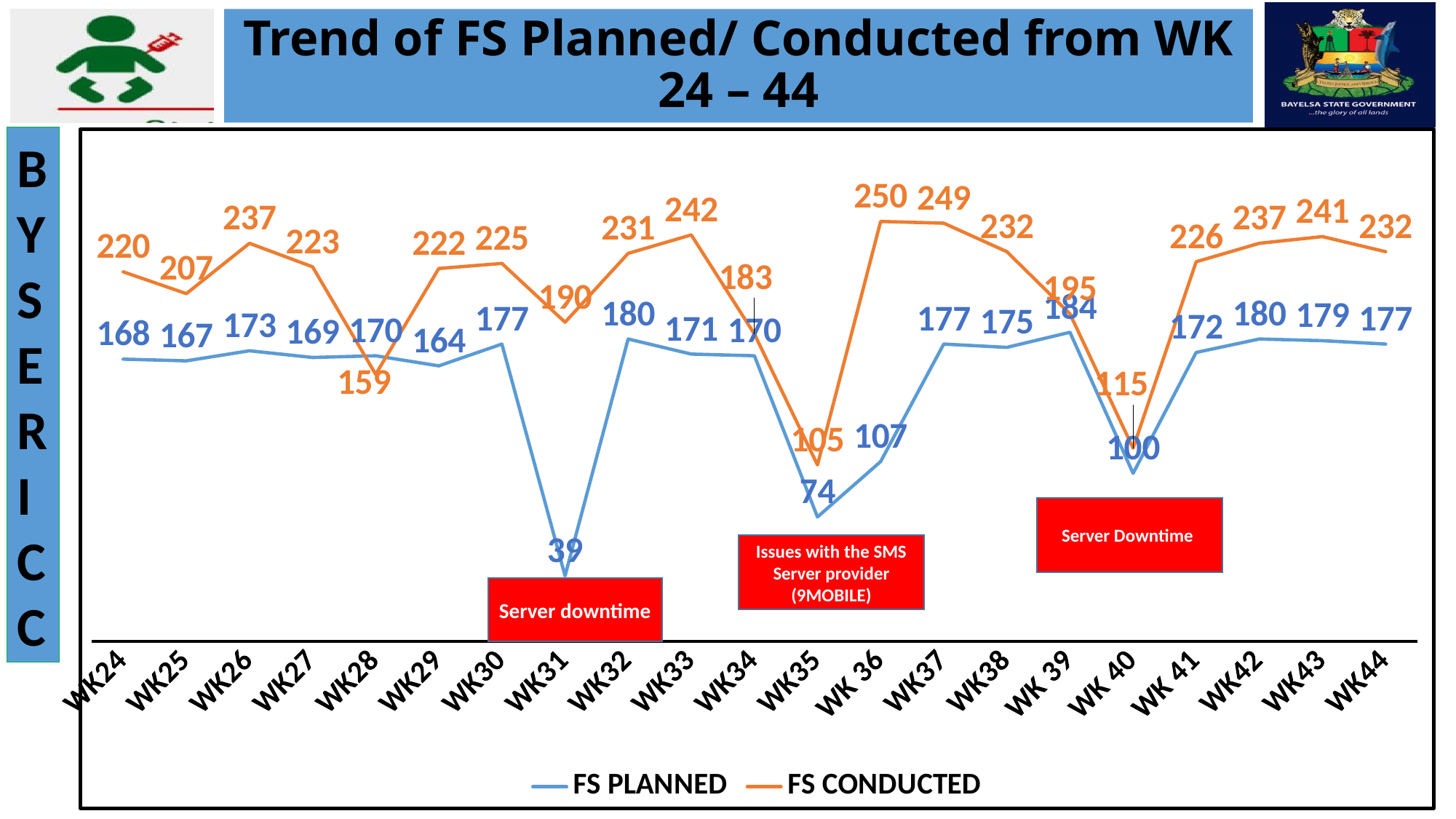
How many weeks are shown on the x axis? 21 In WK28, which series has the larger value, FS PLANNED or FS CONDUCTED? FS PLANNED What is the difference between FS CONDUCTED and FS PLANNED in WK 36? 143 What is the difference between FS CONDUCTED and FS PLANNED in WK24? 52 Does the FS CONDUCTED value rise or fall from WK 41 to WK43? Rises What kind of chart is shown on the slide? Line chart What is the FS CONDUCTED value for WK 40? 115 In which week is the FS CONDUCTED value highest? WK 36 In which week is the FS PLANNED value lowest? WK31 How many series does the legend list? 2 What is the FS CONDUCTED value for WK33? 242 What is the FS PLANNED value for WK31? 39